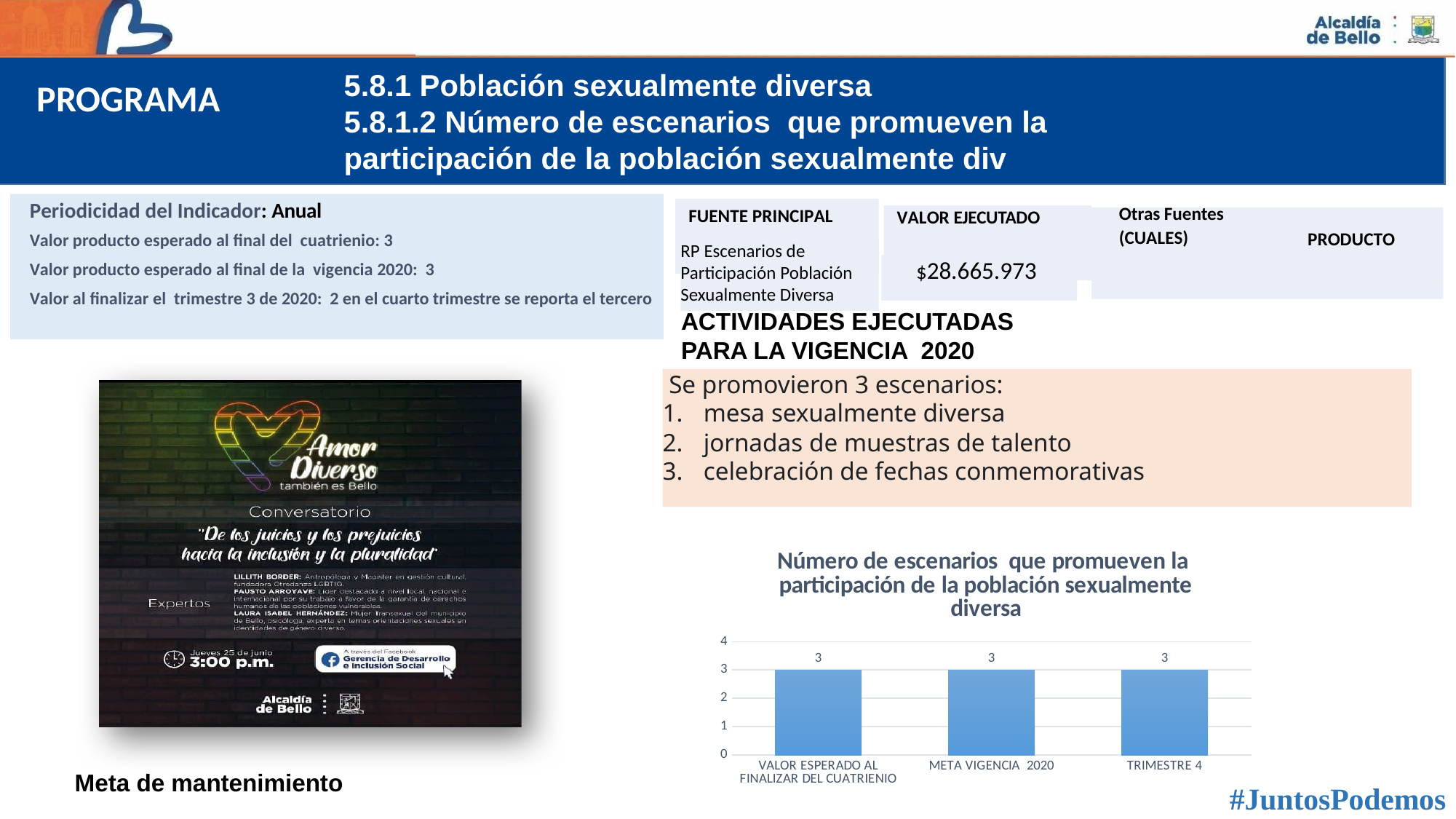
Do the values rise, fall or stay the same across the categories from left to right? stay the same Is the value for TRIMESTRE 4 greater or less than 2? greater What kind of chart is shown on the slide? bar chart How many categories are shown on the x axis of the chart? 3 What is the value for META VIGENCIA 2020? 3 What is the value for VALOR ESPERADO AL FINALIZAR DEL CUATRIENIO? 3 What is the difference between the value for META VIGENCIA 2020 and the value for TRIMESTRE 4? 0 What is the title of the chart? Número de escenarios que promueven la participación de la población sexualmente diversa What is the highest value shown on the chart's vertical axis? 4 What is the value for TRIMESTRE 4? 3 Is the value for META VIGENCIA 2020 greater or less than 4? less